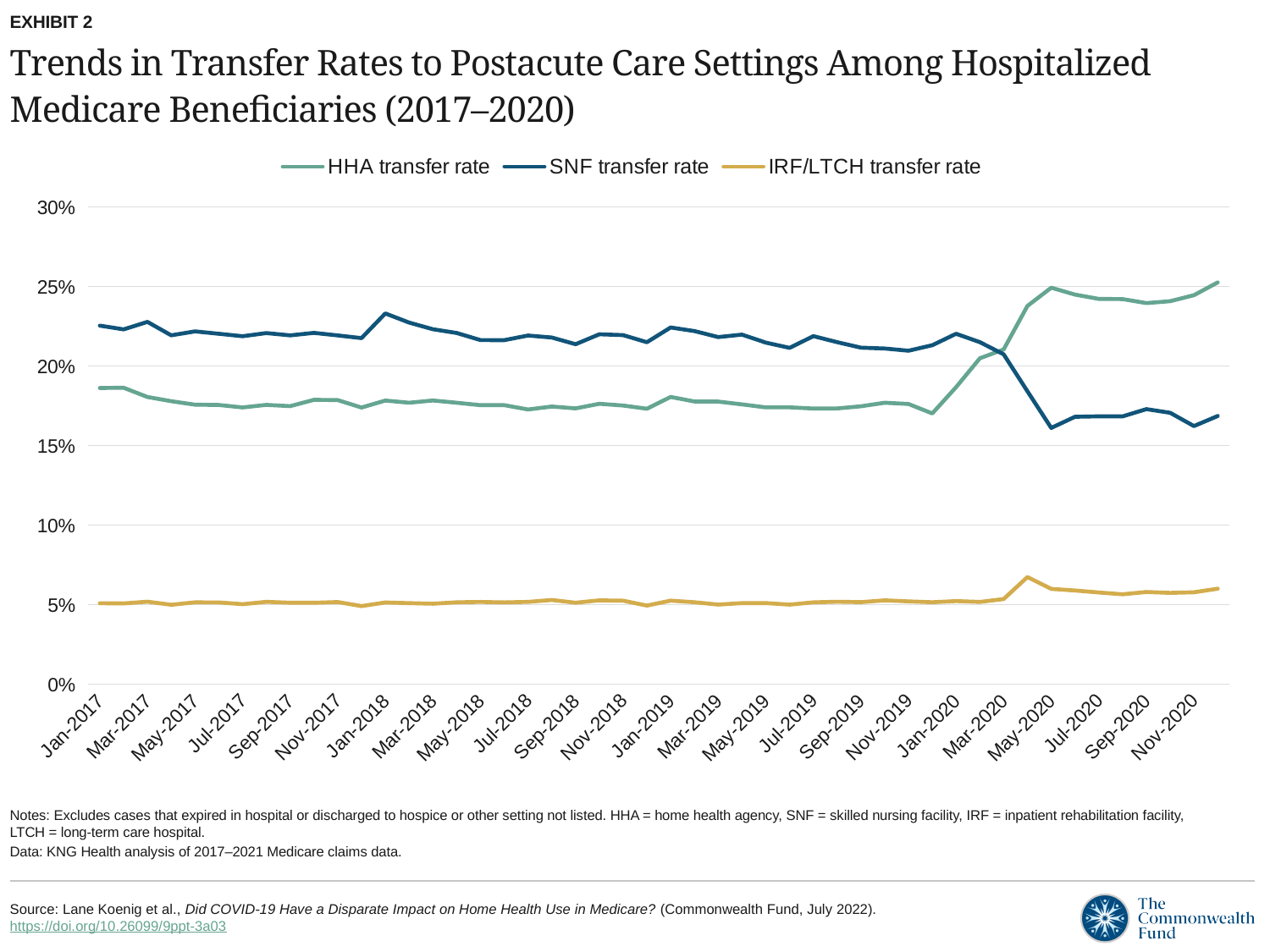
Is the HHA transfer rate in Nov-2020 greater or less than 20%? greater Does the SNF transfer rate rise or fall between Mar-2020 and May-2020? fall What kind of chart is shown on the slide? Line chart Is the SNF transfer rate in Jan-2017 greater or less than 20%? greater Which series has the lowest values across the whole period? IRF/LTCH transfer rate Is the SNF transfer rate in Nov-2020 greater or less than 20%? less What is the title of the chart? Trends in Transfer Rates to Postacute Care Settings Among Hospitalized Medicare Beneficiaries (2017–2020) In Nov-2020, which is higher, the HHA transfer rate or the SNF transfer rate? HHA transfer rate How many series does the legend list? 3 What are the three series named in the legend? HHA transfer rate, SNF transfer rate, IRF/LTCH transfer rate In Jan-2017, which is higher, the HHA transfer rate or the SNF transfer rate? SNF transfer rate